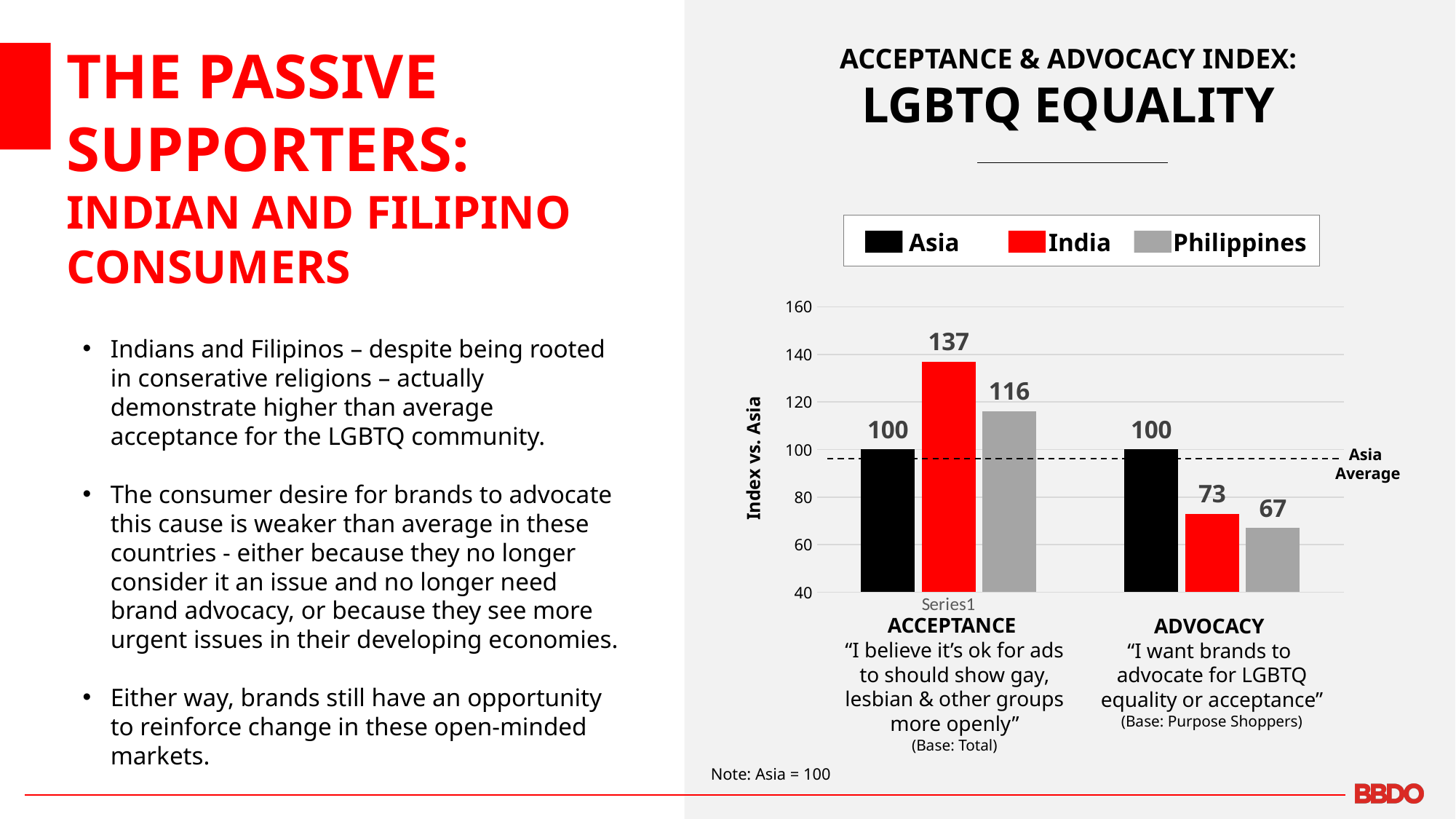
How many series does the legend list? 3 What colour are the India bars in the chart? Red What is the India value for Acceptance? 137 What is the Asia value for Advocacy? 100 Which series has the lowest value for Advocacy? Philippines What is the y-axis label of the chart? Index vs. Asia What kind of chart is shown on the slide? Bar chart Which is larger, the India value for Acceptance or the India value for Advocacy? Acceptance What is the difference between the India and Philippines values for Acceptance? 21 What is the Philippines value for Advocacy? 67 Which series has the highest value for Acceptance? India What is the difference between the Asia and India values for Advocacy? 27